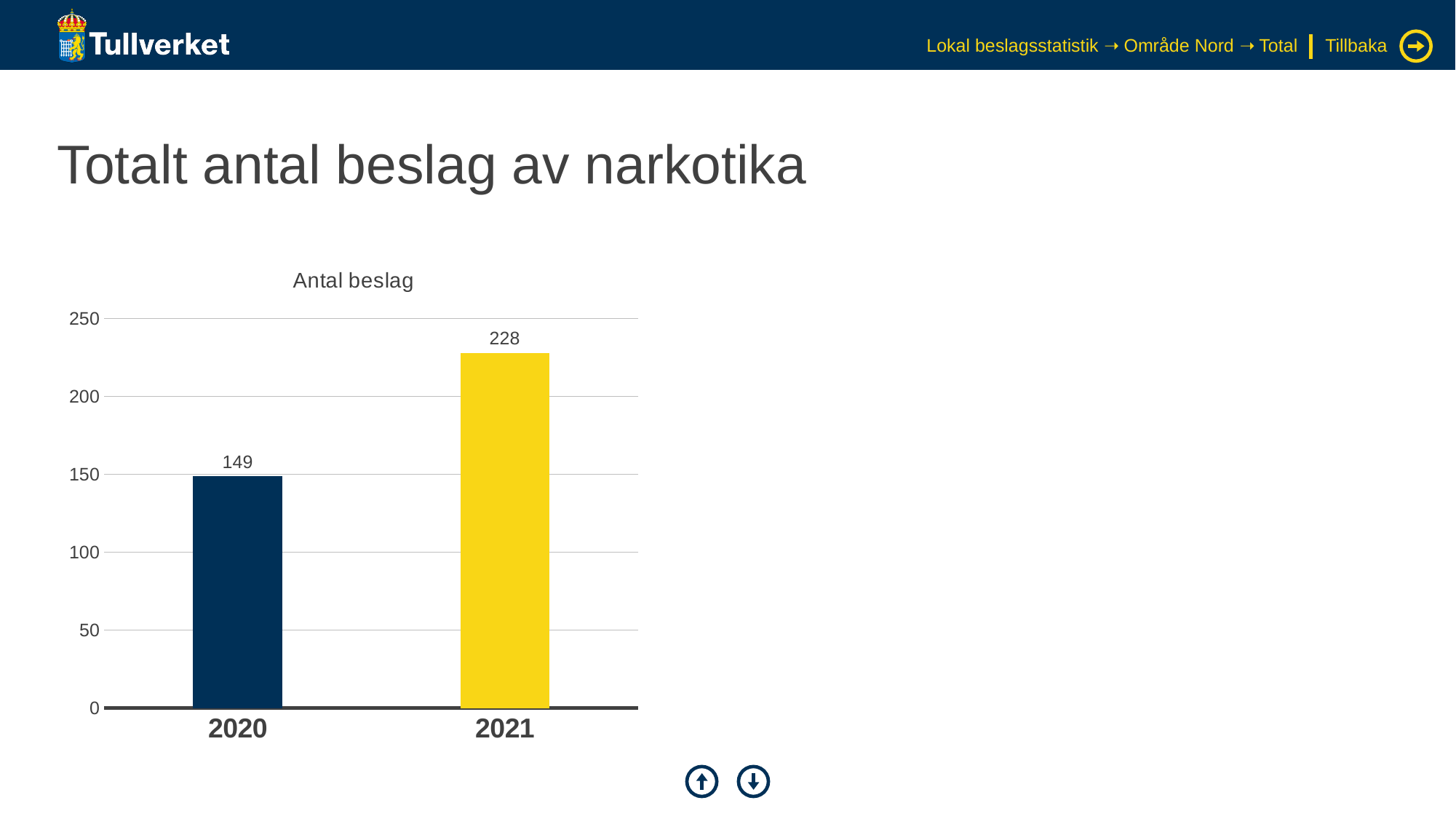
Do the values rise or fall from 2020 to 2021? rise Is the value for 2020 greater or less than 150? less How many categories are shown on the x axis? 2 What is the title of the chart? Antal beslag Which year has the lowest number of seizures? 2020 Which is larger, the value for 2020 or the value for 2021? 2021 What is the value for 2020? 149 Is the value for 2021 greater or less than 200? greater What is the value for 2021? 228 Which year has the highest number of seizures? 2021 What kind of chart is shown on the slide? bar chart What is the difference between the values for 2021 and 2020? 79